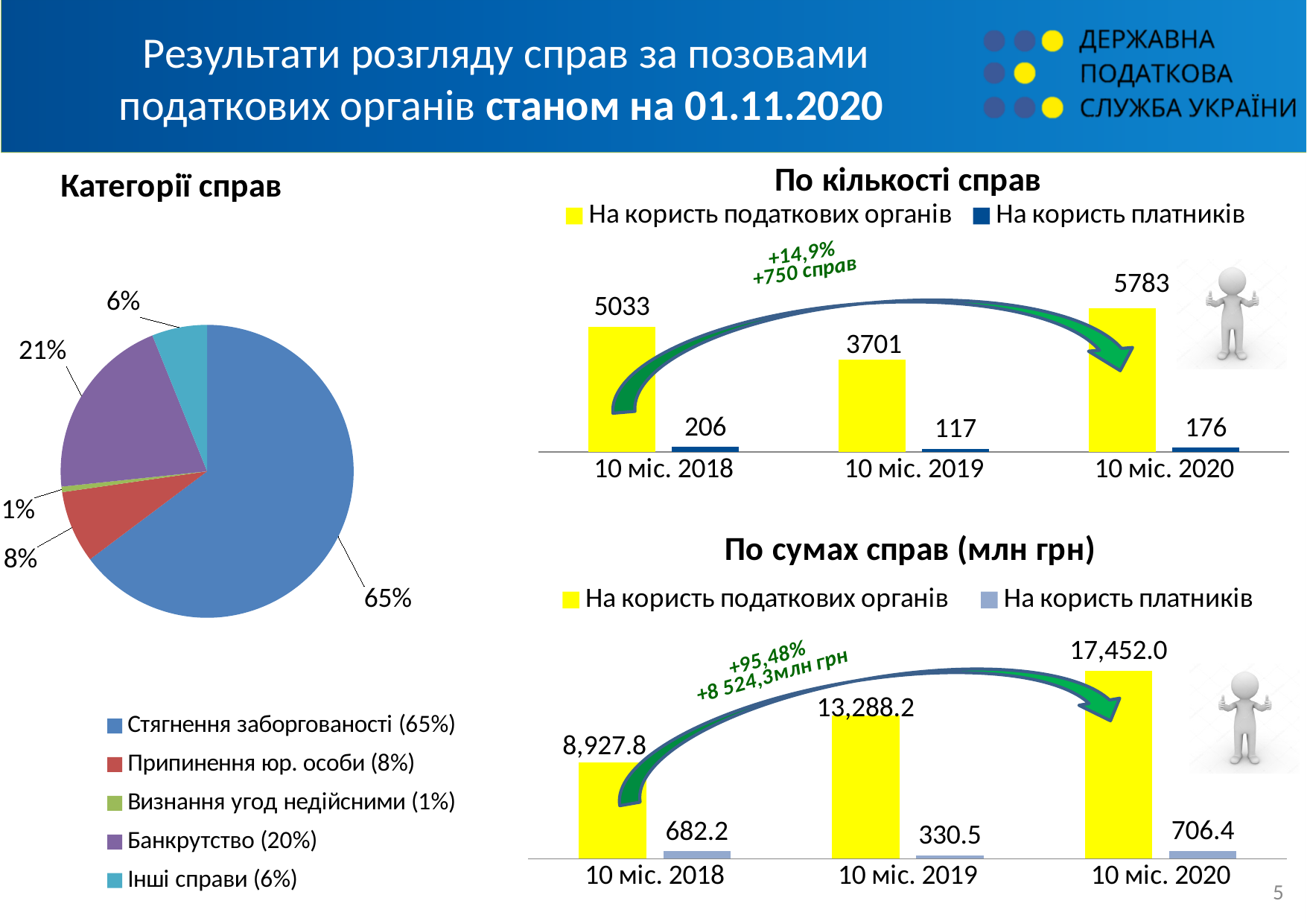
In the chart 'По сумах справ (млн грн)', is the value for 'На користь платників' in 10 міс. 2018 larger or smaller than in 10 міс. 2019? larger In the chart 'По кількості справ', what is the difference between the 'На користь платників' values for 10 міс. 2018 and 10 міс. 2020? 30 In the chart 'Категорії справ', how many categories does the legend list? 5 In the chart 'По кількості справ', what is the value for 'На користь податкових органів' in 10 міс. 2020? 5783 What kind of chart is 'Категорії справ'? pie chart In the chart 'По кількості справ', what is the value for 'На користь платників' in 10 міс. 2019? 117 In the chart 'По сумах справ (млн грн)', which period has the highest value for 'На користь платників'? 10 міс. 2020 In the chart 'По кількості справ', which period has the lowest value for 'На користь податкових органів'? 10 міс. 2019 In the chart 'По сумах справ (млн грн)', does the value for 'На користь податкових органів' rise or fall from 10 міс. 2018 to 10 міс. 2020? rise In the chart 'По сумах справ (млн грн)', what is the value for 'На користь податкових органів' in 10 міс. 2019? 13,288.2 In the chart 'По сумах справ (млн грн)', how many series does the legend list? 2 In the chart 'Категорії справ', what share of the pie is 'Стягнення заборгованості'? 65%